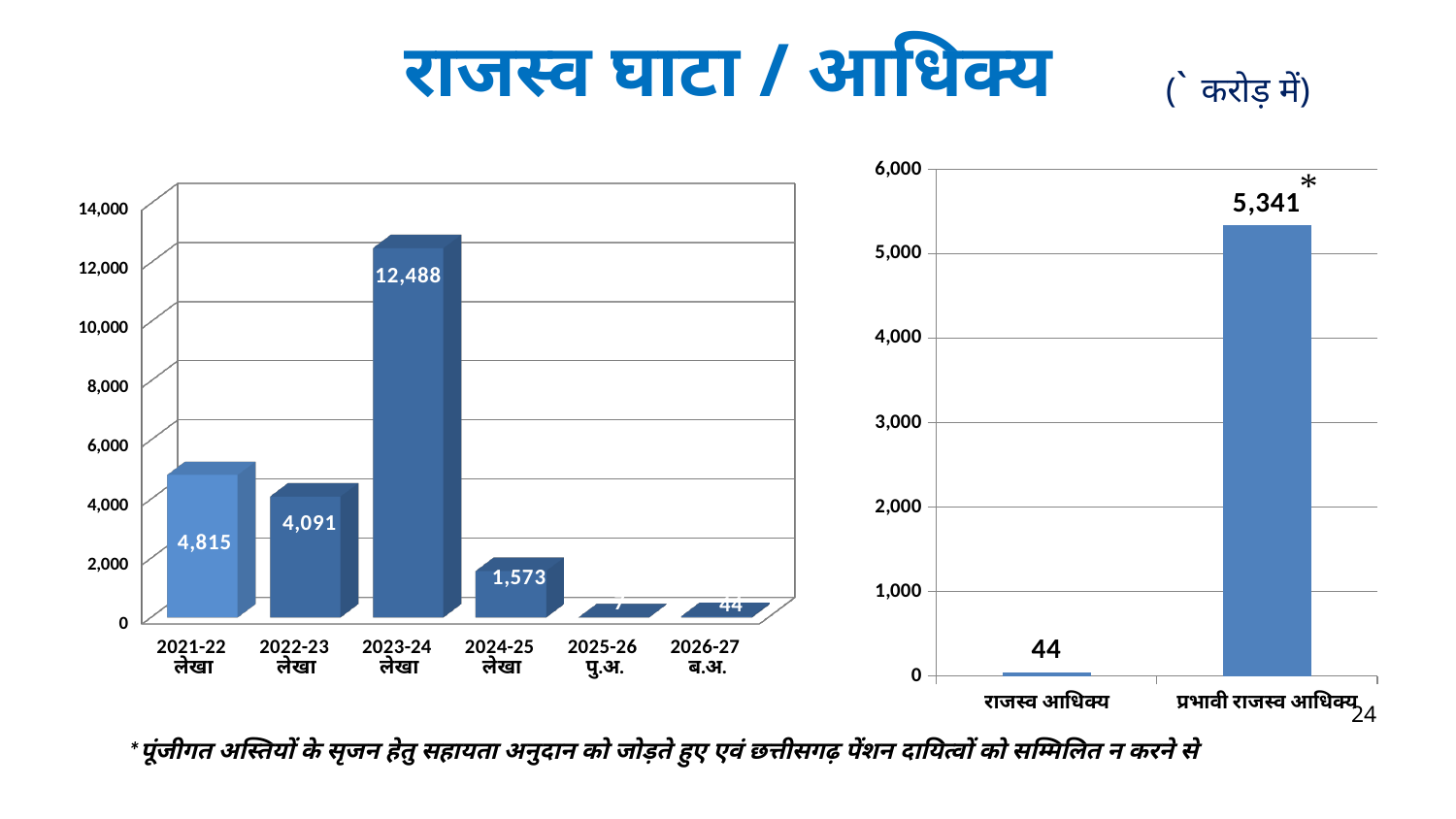
In the left chart, which is larger: the value for 2022-23 लेखा or 2024-25 लेखा? 2022-23 लेखा How many categories are shown on the x axis of the left chart? 6 In the left chart, which year has the highest value? 2023-24 लेखा In the left chart, what is the value for 2023-24 लेखा? 12,488 In the right chart, what is the value for प्रभावी राजस्व आधिक्य? 5,341 In the right chart, what is the difference between प्रभावी राजस्व आधिक्य and राजस्व आधिक्य? 5,297 In the right chart, what is the value for राजस्व आधिक्य? 44 What type of chart is the right chart? bar chart In the left chart, is the value for 2023-24 लेखा greater or less than 10,000? greater In the left chart, what is the value for 2024-25 लेखा? 1,573 In the left chart, what is the value for 2021-22 लेखा? 4,815 In the left chart, what is the difference between the values for 2021-22 लेखा and 2022-23 लेखा? 724